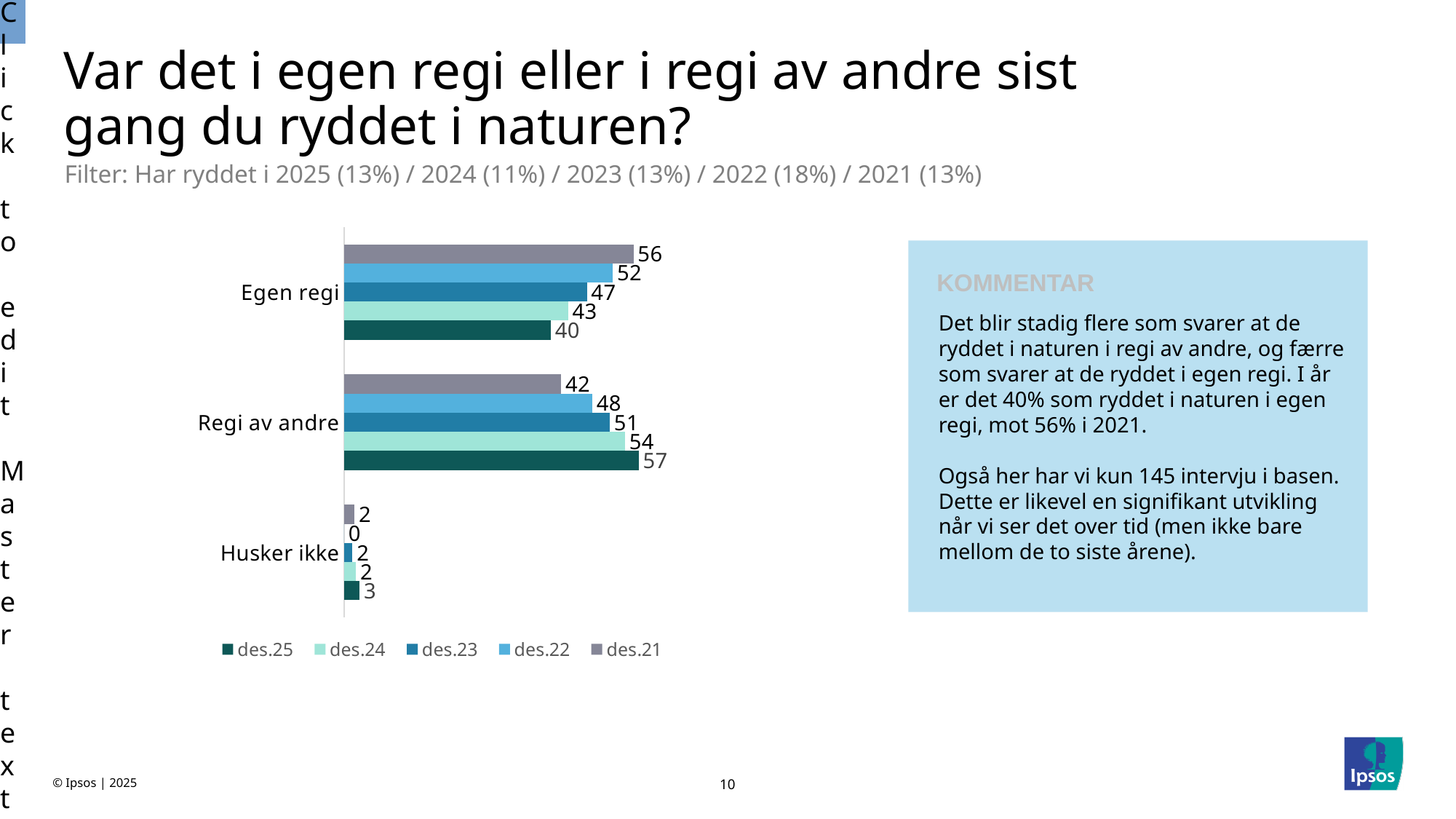
What is the value for Regi av andre in the des.21 series? 42 What is the value for Husker ikke in the des.22 series? 0 How many categories are shown on the chart? 3 How many series does the legend list? 5 Which series has the lowest value for Egen regi? des.25 Which series is shown in the darkest teal colour in the legend? des.25 Which is larger for the des.24 series: Egen regi or Regi av andre? Regi av andre What is the difference between the des.21 and des.25 values for Egen regi? 16 What is the value for Egen regi in the des.23 series? 47 What is the value for Egen regi in the des.25 series? 40 What kind of chart is shown on the slide? Bar chart Which series has the highest value for Regi av andre? des.25